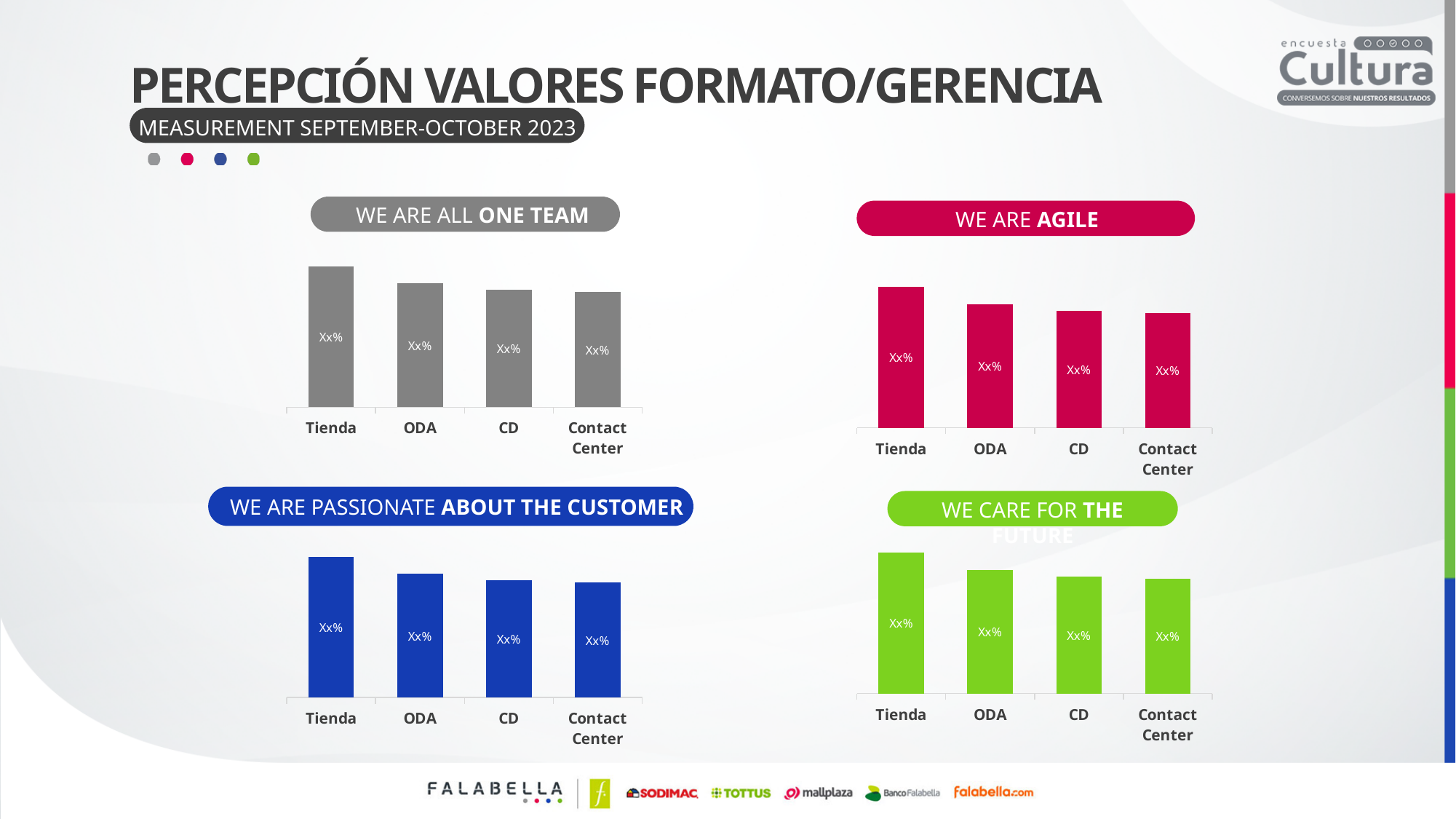
In the "WE ARE PASSIONATE ABOUT THE CUSTOMER" chart, do the bars rise or fall from Tienda to Contact Center? fall In the "WE ARE ALL ONE TEAM" chart, which category has the tallest bar? Tienda In the "WE ARE AGILE" chart, which category has the highest value? Tienda In the "WE CARE FOR THE FUTURE" chart, which category has the highest value? Tienda How many categories are shown in the "WE ARE AGILE" chart? 4 What colour are the bars in the "WE ARE PASSIONATE ABOUT THE CUSTOMER" chart? blue In the "WE CARE FOR THE FUTURE" chart, which is larger, the bar for ODA or the bar for Contact Center? ODA In the "WE ARE AGILE" chart, which is larger, the bar for Tienda or the bar for ODA? Tienda What is the label of the last category on the x axis of the "WE CARE FOR THE FUTURE" chart? Contact Center How many bar charts are shown on the slide? 4 What kind of chart is used under the heading "WE ARE ALL ONE TEAM"? bar chart